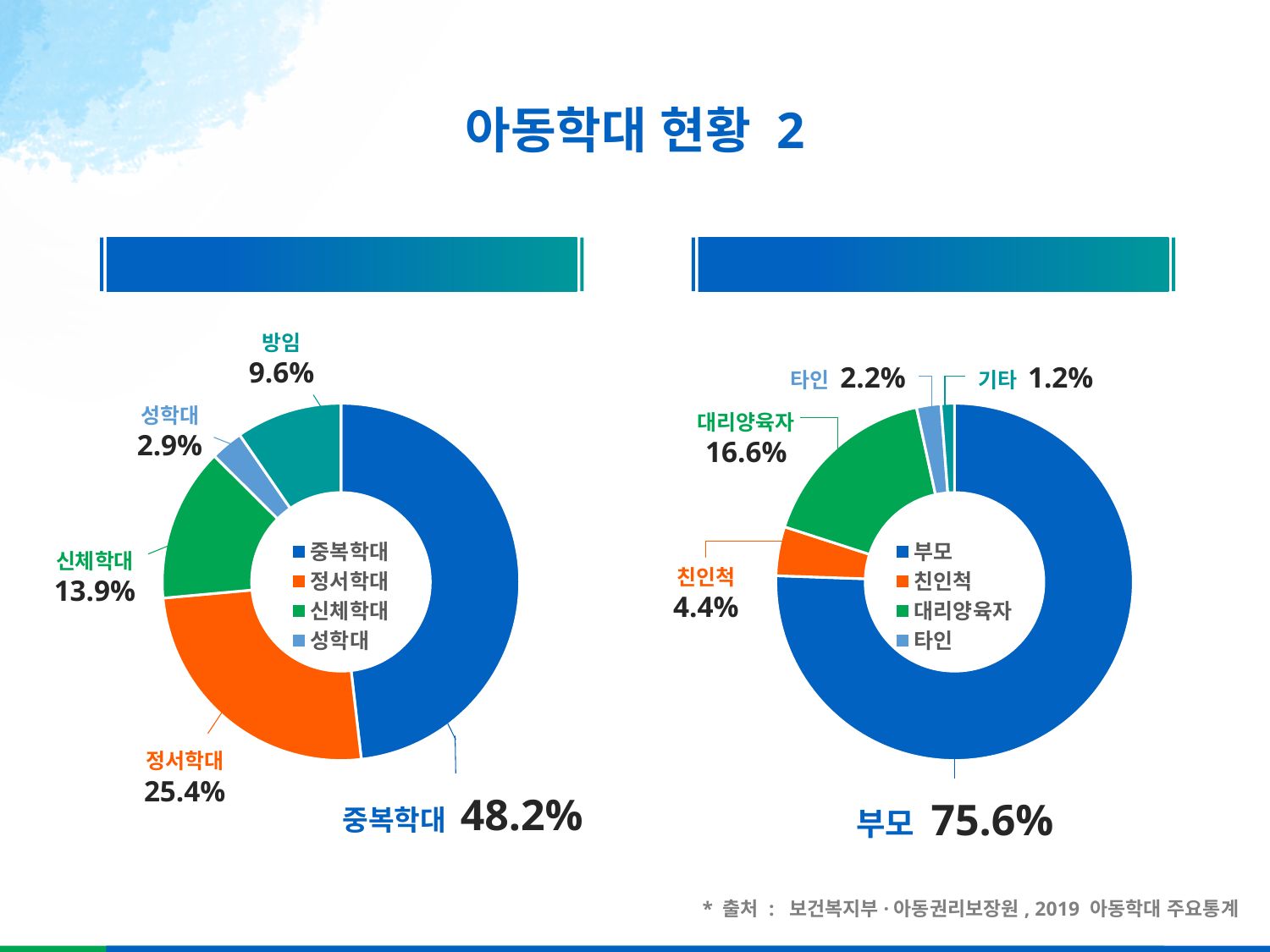
What kind of chart is the left chart? Donut (pie) chart On the left chart, which category has the largest share? 중복학대 On the left chart, what is the value for 중복학대? 48.2% On the right chart, which is larger, 친인척 or 타인? 친인척 How many categories are labelled on the right chart? 5 On the left chart, what is the difference between 정서학대 and 신체학대? 11.5% On the left chart, which category has the smallest share? 성학대 On the right chart, what is the value for 대리양육자? 16.6% On the right chart, what is the value for 기타? 1.2% On the left chart, what is the value for 정서학대? 25.4% On the right chart, which category has the smallest share? 기타 On the right chart, what is the difference between 부모 and 대리양육자? 59.0%